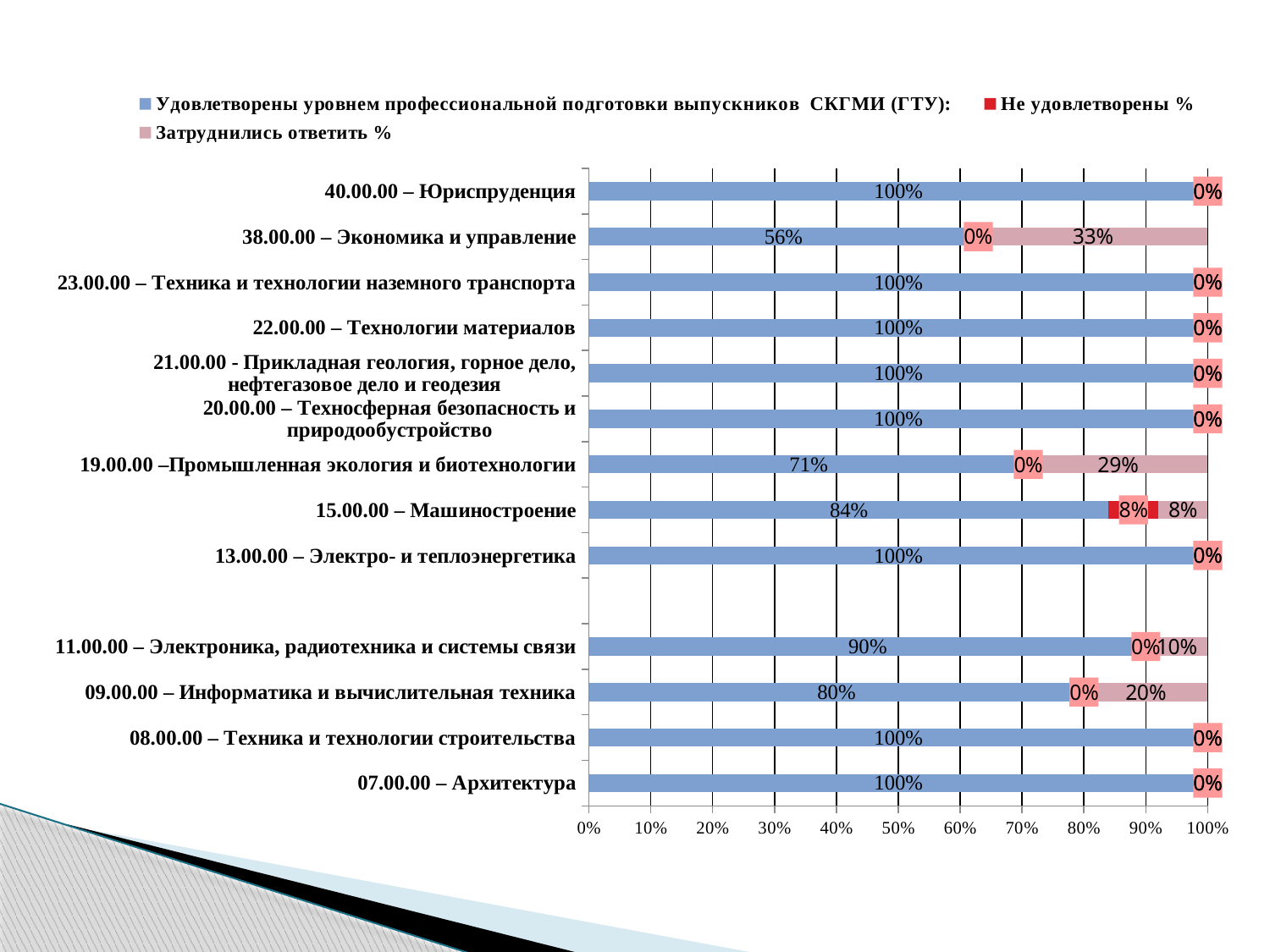
What is the difference between the satisfied shares of 11.00.00 – Электроника, радиотехника и системы связи and 09.00.00 – Информатика и вычислительная техника? 10% What is the satisfied share (Удовлетворены) for 38.00.00 – Экономика и управление? 56% Which category has the highest 'Затруднились ответить' value? 38.00.00 – Экономика и управление Which category is the only one with a non-zero 'Не удовлетворены' value? 15.00.00 – Машиностроение Which category has the lowest satisfied share (Удовлетворены)? 38.00.00 – Экономика и управление What is the 'Не удовлетворены' value for 15.00.00 – Машиностроение? 8% What is the total of the stacked bar for 15.00.00 – Машиностроение? 100% What kind of chart is shown on the slide? Stacked horizontal bar chart What is the 'Затруднились ответить' value for 19.00.00 – Промышленная экология и биотехнологии? 29% Which has a larger satisfied share: 19.00.00 – Промышленная экология и биотехнологии or 15.00.00 – Машиностроение? 15.00.00 – Машиностроение How many series does the legend list? 3 How many categories (specialty groups) are shown on the chart? 13